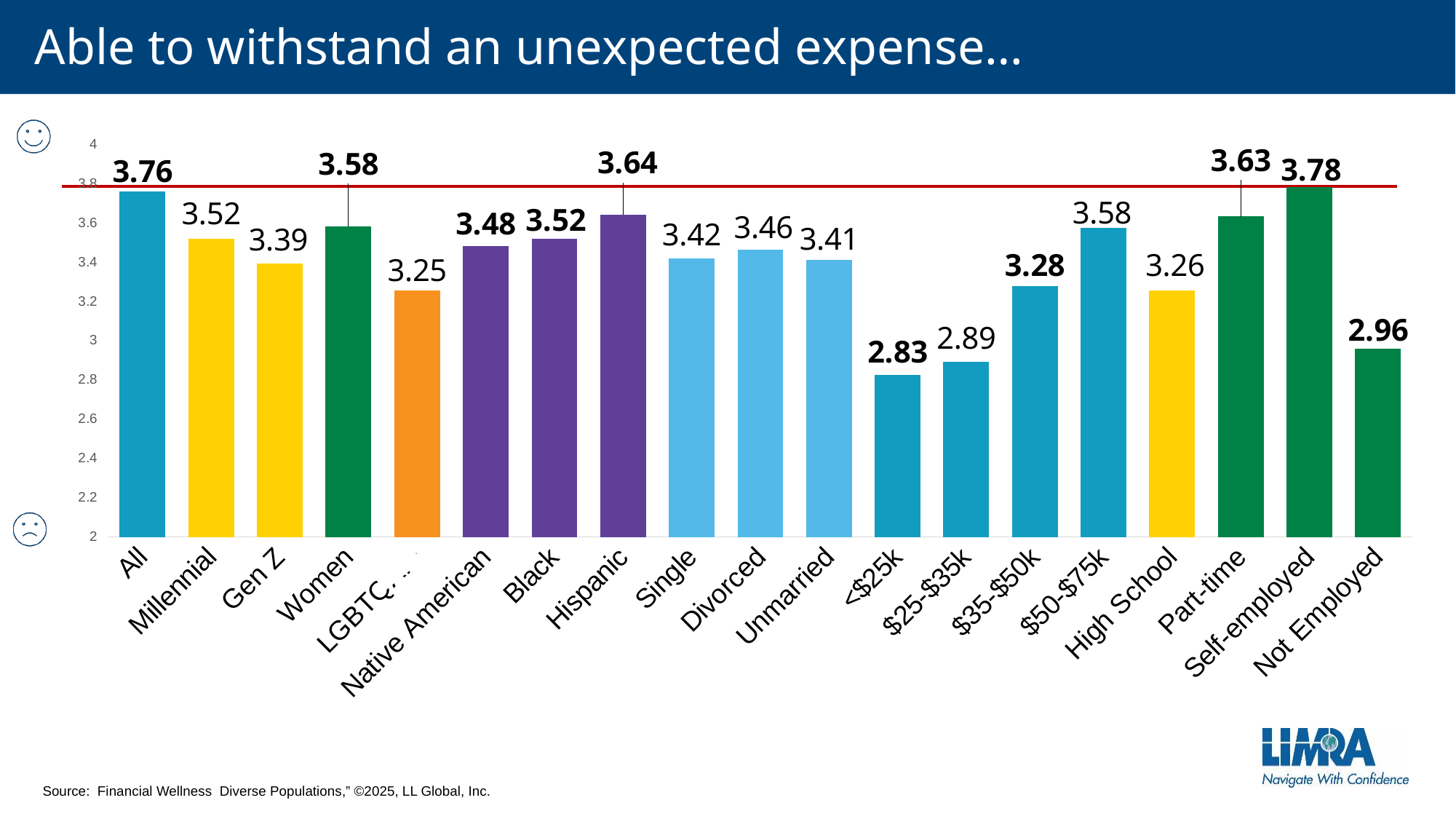
What is the value for Gen Z? 3.39 What kind of chart is shown on the slide? Bar chart How many categories are shown on the chart? 19 Which category has the highest value? Self-employed Which category has the lowest value? <$25k What is the value for Self-employed? 3.78 Which is larger, the value for Part-time or the value for Divorced? Part-time What is the difference between the values for Women and High School? 0.32 What is the value for Not Employed? 2.96 Is the value for $25-$35k greater or less than 3? less What is the value for Hispanic? 3.64 What is the difference between the values for All and <$25k? 0.93